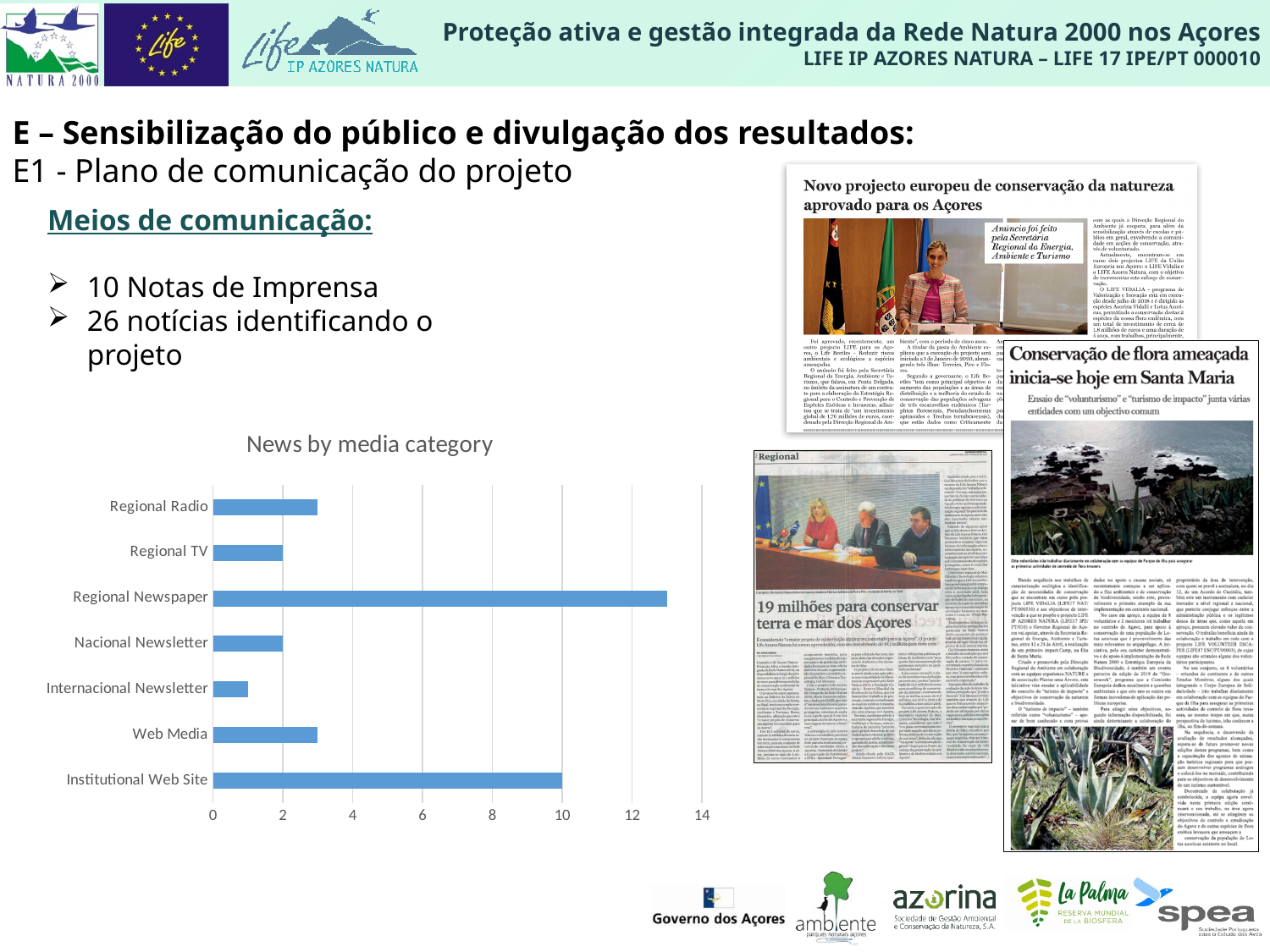
Which media category has the highest number of news items? Regional Newspaper Which has more news items, Regional Newspaper or Regional Radio? Regional Newspaper What kind of chart is used to show news by media category? bar chart What is the title of the chart on the slide? News by media category Is the value for Regional Newspaper greater or less than 12? greater Is the value for Regional Radio greater or less than 2? greater What is the value for Institutional Web Site? 10 What is the value for Regional TV? 2 Is the value for Internacional Newsletter greater or less than 2? less Which has more news items, Institutional Web Site or Web Media? Institutional Web Site How many media categories are shown in the chart? 7 Which media category has the lowest number of news items? Internacional Newsletter